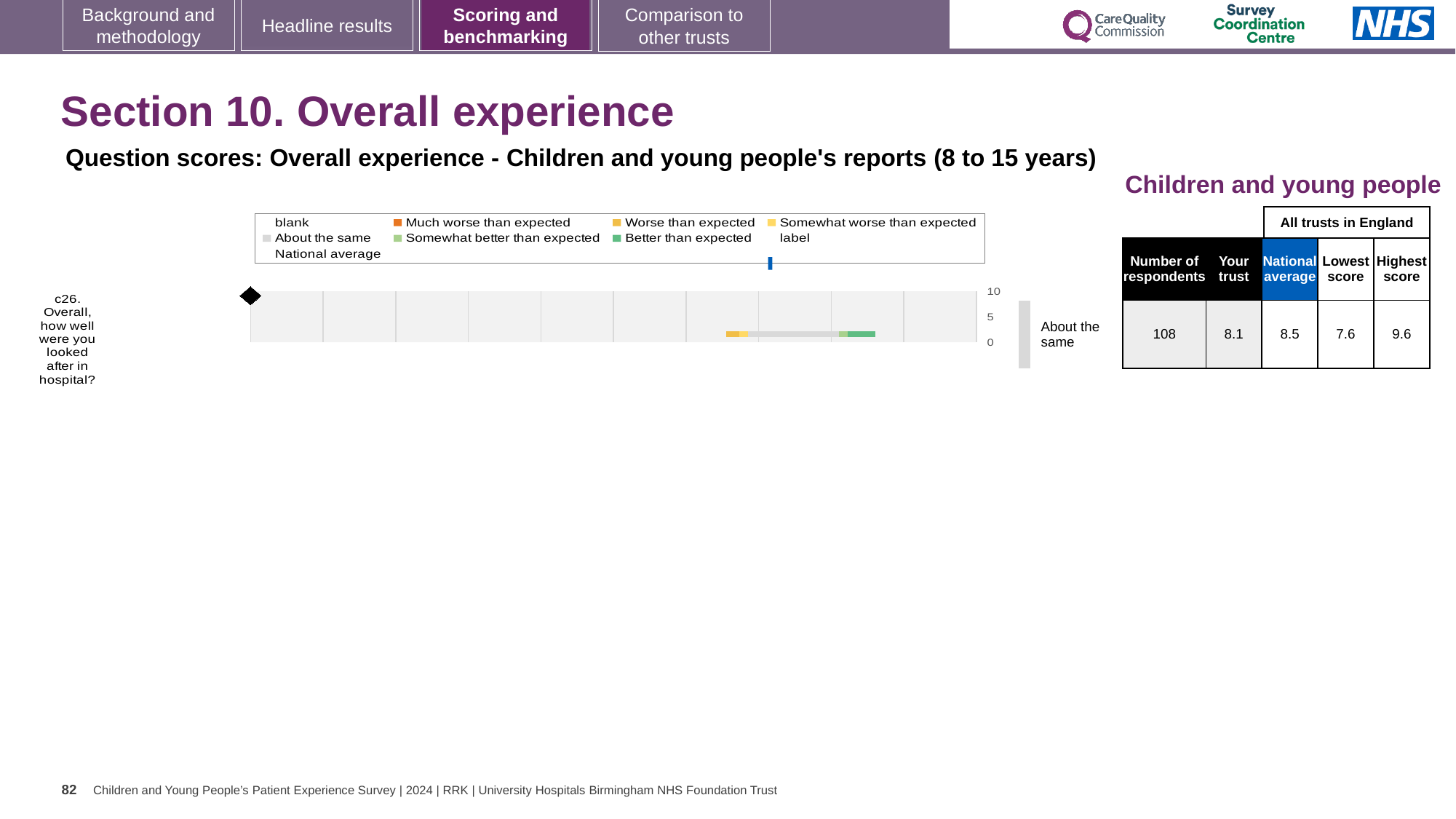
What is the national average score for question c26? 8.5 What is the highest score among all trusts in England for question c26? 9.6 What kind of chart is used to show the question score for c26? bar chart What is the difference between the highest score (9.6) and the lowest score (7.6) for question c26? 2.0 Is the trust's score for question c26 greater or less than 5 on the chart's axis? greater What is the lowest score among all trusts in England for question c26? 7.6 Which is larger for question c26, the trust's score or the national average? National average What is the difference between the national average (8.5) and the trust's score (8.1) for question c26? 0.4 How many respondents answered question c26? 108 What is the 'Your trust' score for question c26 (Overall, how well were you looked after in hospital?)? 8.1 What benchmark category is shown next to the chart for question c26? About the same How many questions are plotted in the chart? 1